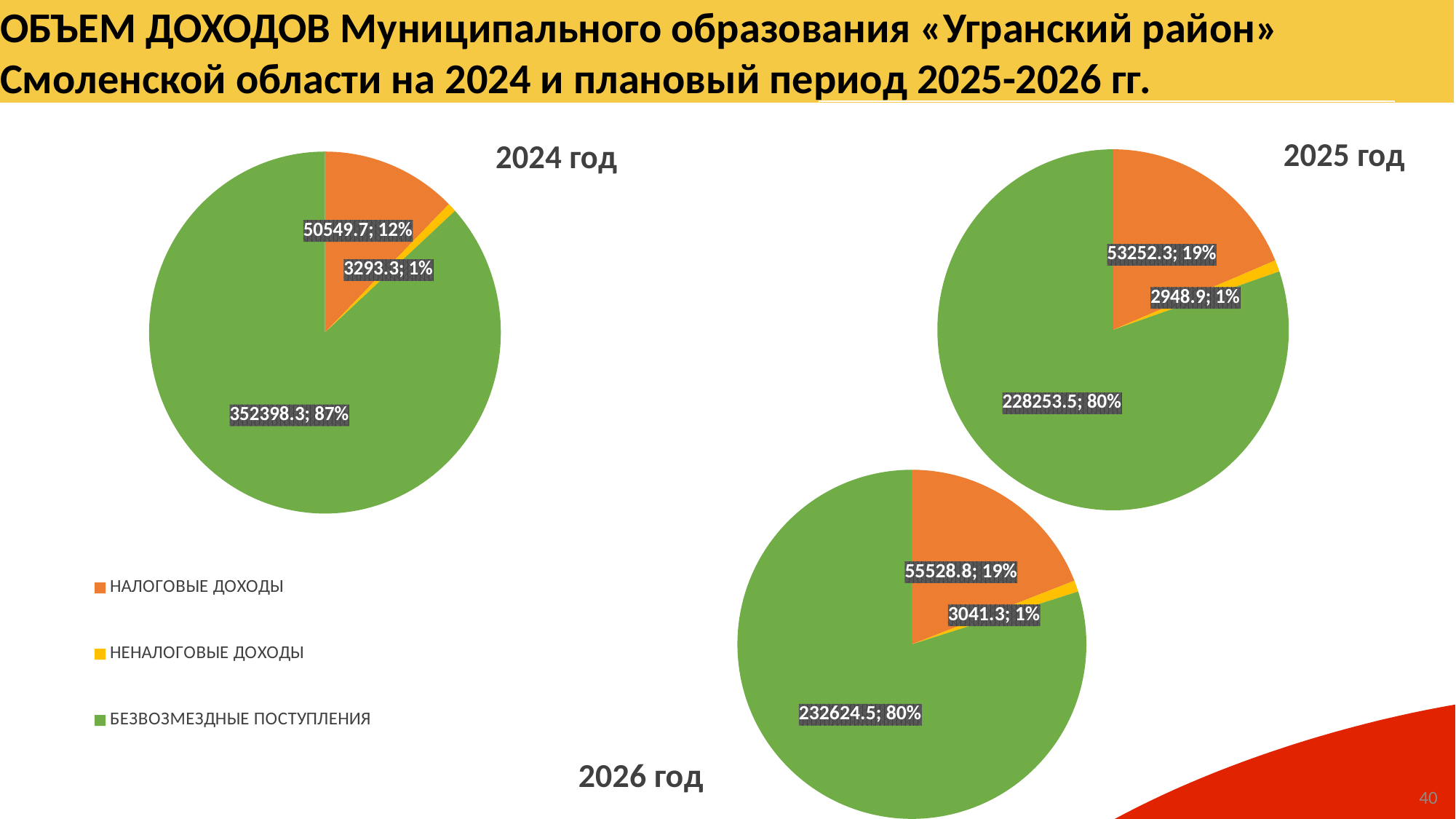
In the 2026 год pie chart, what is the value for БЕЗВОЗМЕЗДНЫЕ ПОСТУПЛЕНИЯ? 232624.5 Which colour represents НЕНАЛОГОВЫЕ ДОХОДЫ in the legend? Yellow What type of chart is used for the 2024 год data? Pie chart In the 2025 год pie chart, what is the value for НЕНАЛОГОВЫЕ ДОХОДЫ? 2948.9 In the 2025 год pie chart, what share of the pie is НАЛОГОВЫЕ ДОХОДЫ? 19% How many categories does each pie chart on the slide show? 3 In the 2026 год pie chart, which category has the smallest slice? НЕНАЛОГОВЫЕ ДОХОДЫ What is the difference between the НАЛОГОВЫЕ ДОХОДЫ value in the 2026 год chart and in the 2025 год chart? 2276.5 In the 2024 год pie chart, what is the value for НАЛОГОВЫЕ ДОХОДЫ? 50549.7 In the 2025 год pie chart, which is larger: НАЛОГОВЫЕ ДОХОДЫ or НЕНАЛОГОВЫЕ ДОХОДЫ? НАЛОГОВЫЕ ДОХОДЫ In the 2024 год pie chart, what share of the pie is БЕЗВОЗМЕЗДНЫЕ ПОСТУПЛЕНИЯ? 87% In the 2024 год pie chart, which category has the largest slice? БЕЗВОЗМЕЗДНЫЕ ПОСТУПЛЕНИЯ